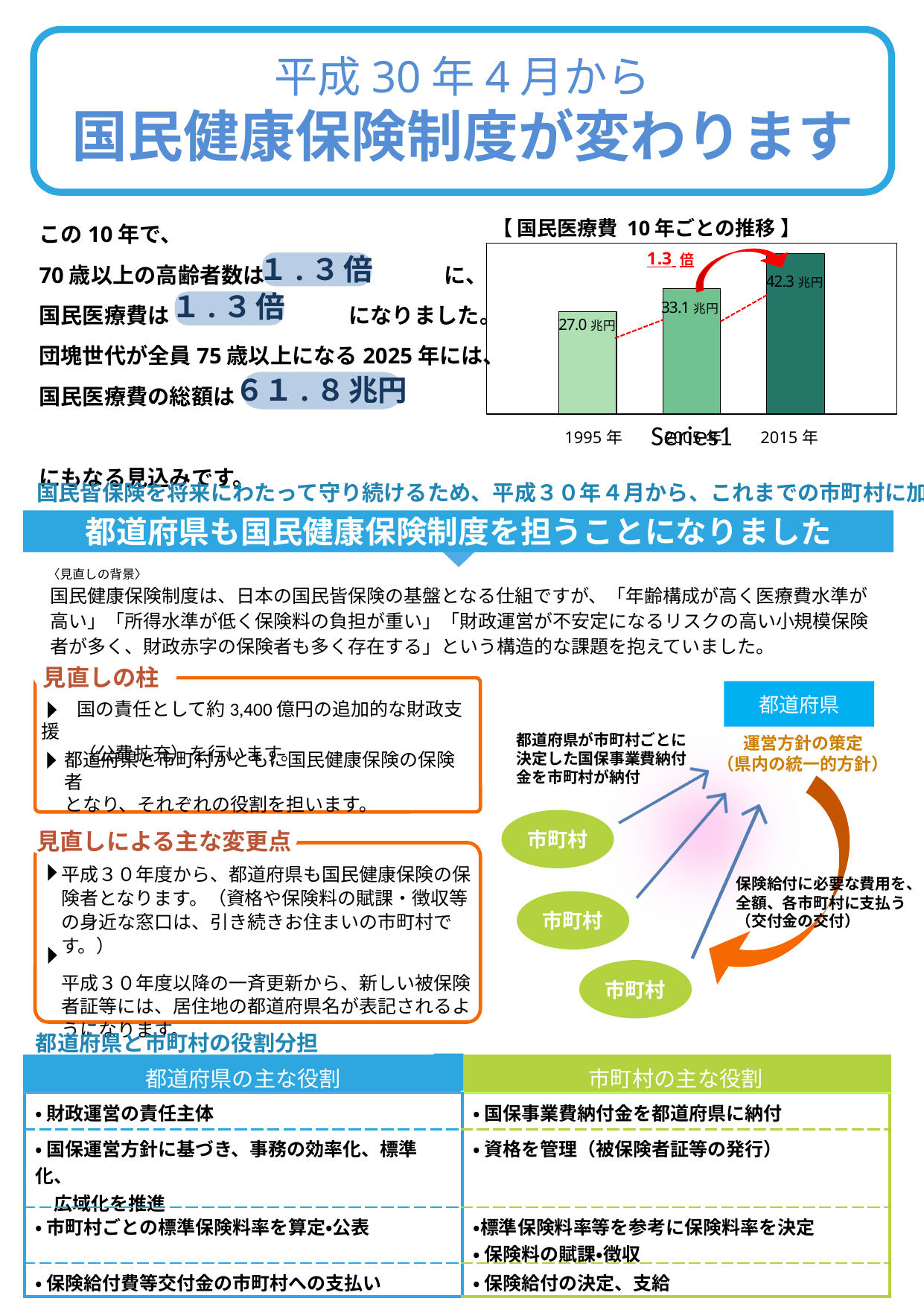
In the 国民医療費 chart, which year has the highest value? 2015年 In the 国民医療費 chart, what is the difference between the 2015年 and 2005年 values? 9.2 兆円 What multiplier is annotated with the red arrow in the 国民医療費 chart? 1.3 倍 In the 国民医療費 chart, what is the difference between the 2015年 and 1995年 values? 15.3 兆円 How many bars are plotted in the 国民医療費 chart? 3 Do the values in the 国民医療費 chart rise or fall from 1995年 to 2015年? rise What kind of chart is shown under the title 【国民医療費 10年ごとの推移】? bar chart In the 国民医療費 chart, what is the value for 1995年? 27.0 兆円 In the 国民医療費 chart, which year has the lowest value? 1995年 In the 国民医療費 chart, which is larger, the value for 1995年 or the value for 2015年? 2015年 In the 国民医療費 chart, what is the value for 2015年? 42.3 兆円 In the 国民医療費 chart, what is the value of the middle bar (2005年)? 33.1 兆円